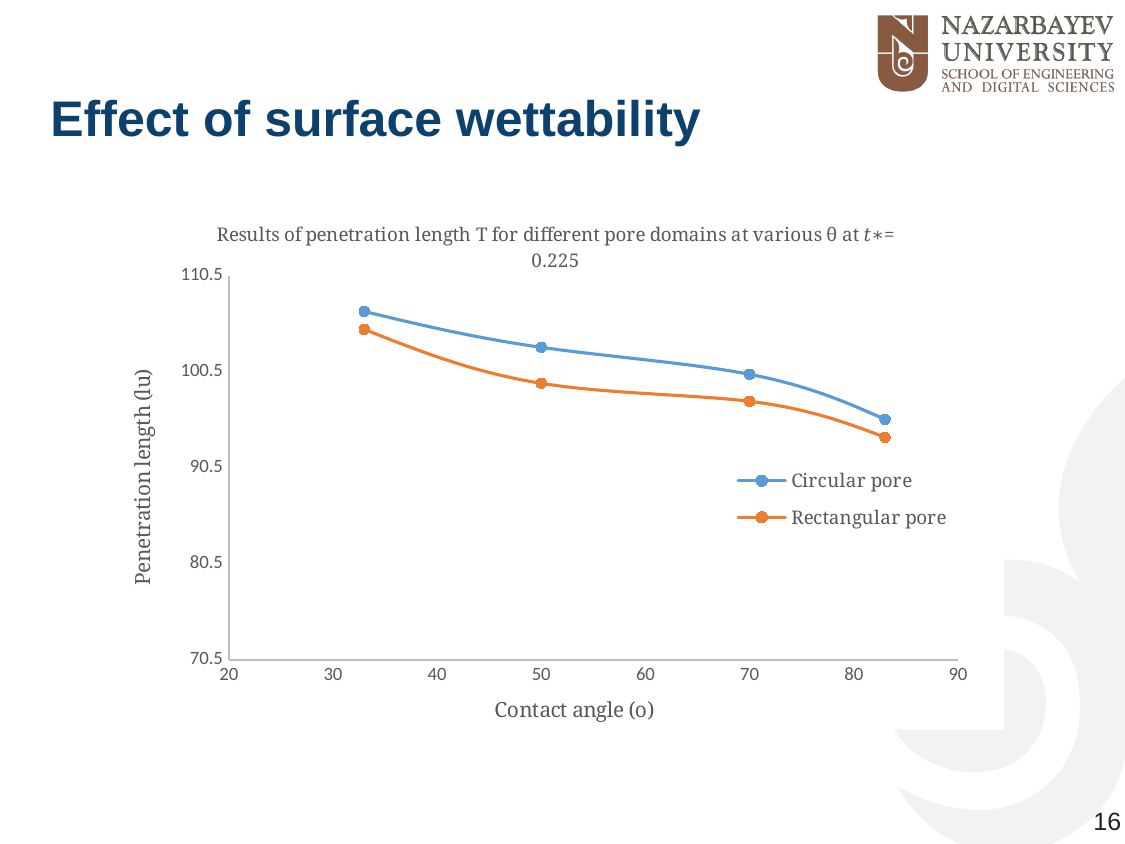
Is the penetration length for the Circular pore at a contact angle of about 50 greater or less than 100.5? greater Is the penetration length for the Rectangular pore at a contact angle of about 70 greater or less than 100.5? less Do the penetration length values rise or fall as the contact angle increases? Fall Is the penetration length for the Circular pore at its highest contact angle (about 83) greater or less than 90.5? greater How many series does the legend list? 2 How many data points are plotted for the Circular pore series? 4 What kind of chart is shown on the slide? Line chart What is the label of the y axis? Penetration length (lu) At which contact angle does the Rectangular pore series reach its lowest penetration length, the lowest or the highest contact angle plotted? The highest contact angle Which series has the higher penetration length at every contact angle, Circular pore or Rectangular pore? Circular pore Which colour is used for the Rectangular pore series? Orange